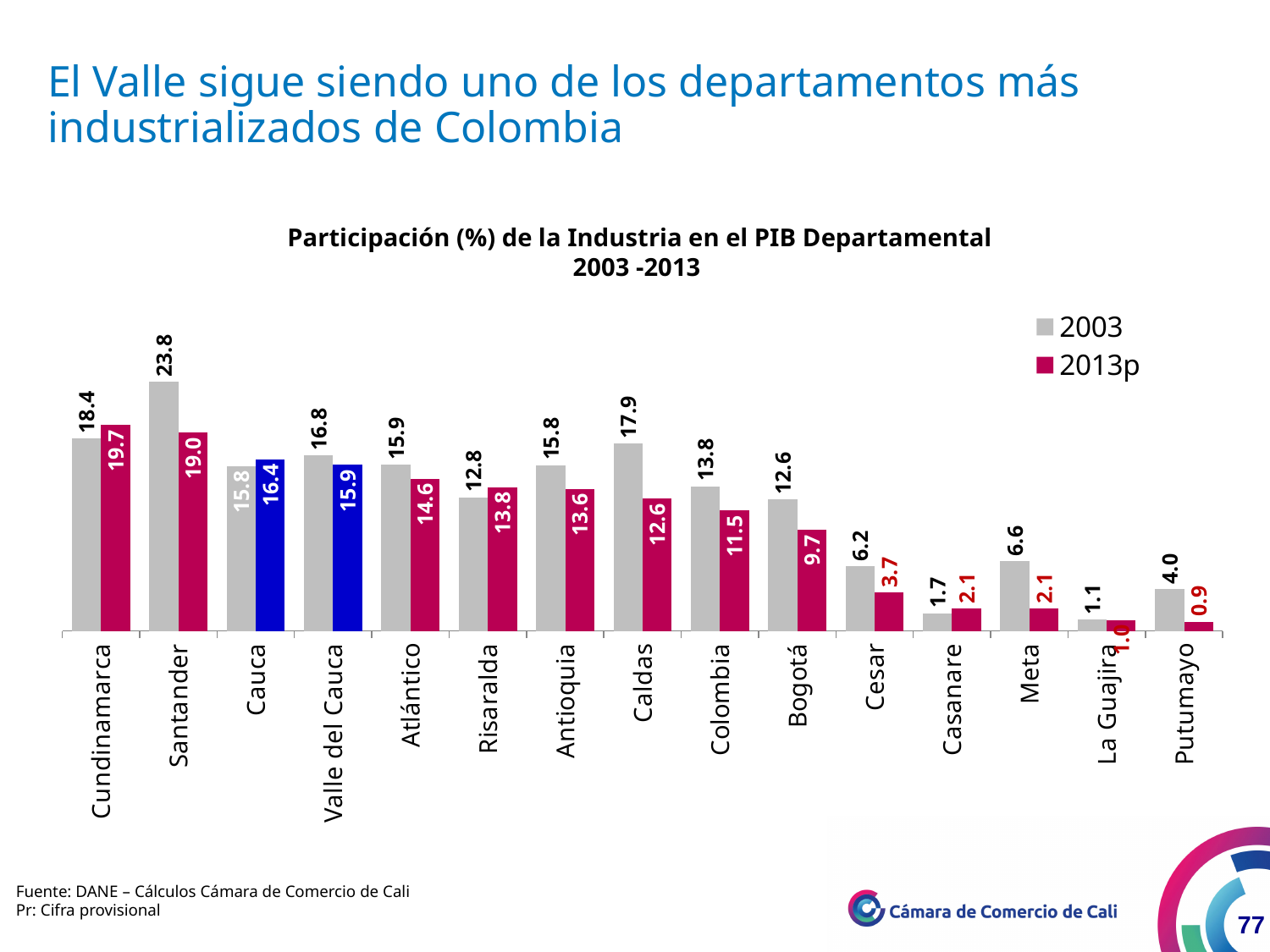
What is the 2013p value for Bogotá? 9.7 What is the title of the chart? Participación (%) de la Industria en el PIB Departamental 2003 -2013 What is the 2013p value for Valle del Cauca? 15.9 How many departments (categories) are shown on the x axis? 15 What is the difference between the 2013p values of Santander and Cauca? 2.6 How many series does the legend list? 2 What is the 2003 value for Santander? 23.8 What is the difference between the 2003 and 2013p values for Caldas? 5.3 Which department has the lowest 2013p value? Putumayo Which department has the highest 2003 value? Santander What type of chart is shown on the slide? bar chart Which is larger for Cundinamarca, the 2003 value or the 2013p value? 2013p